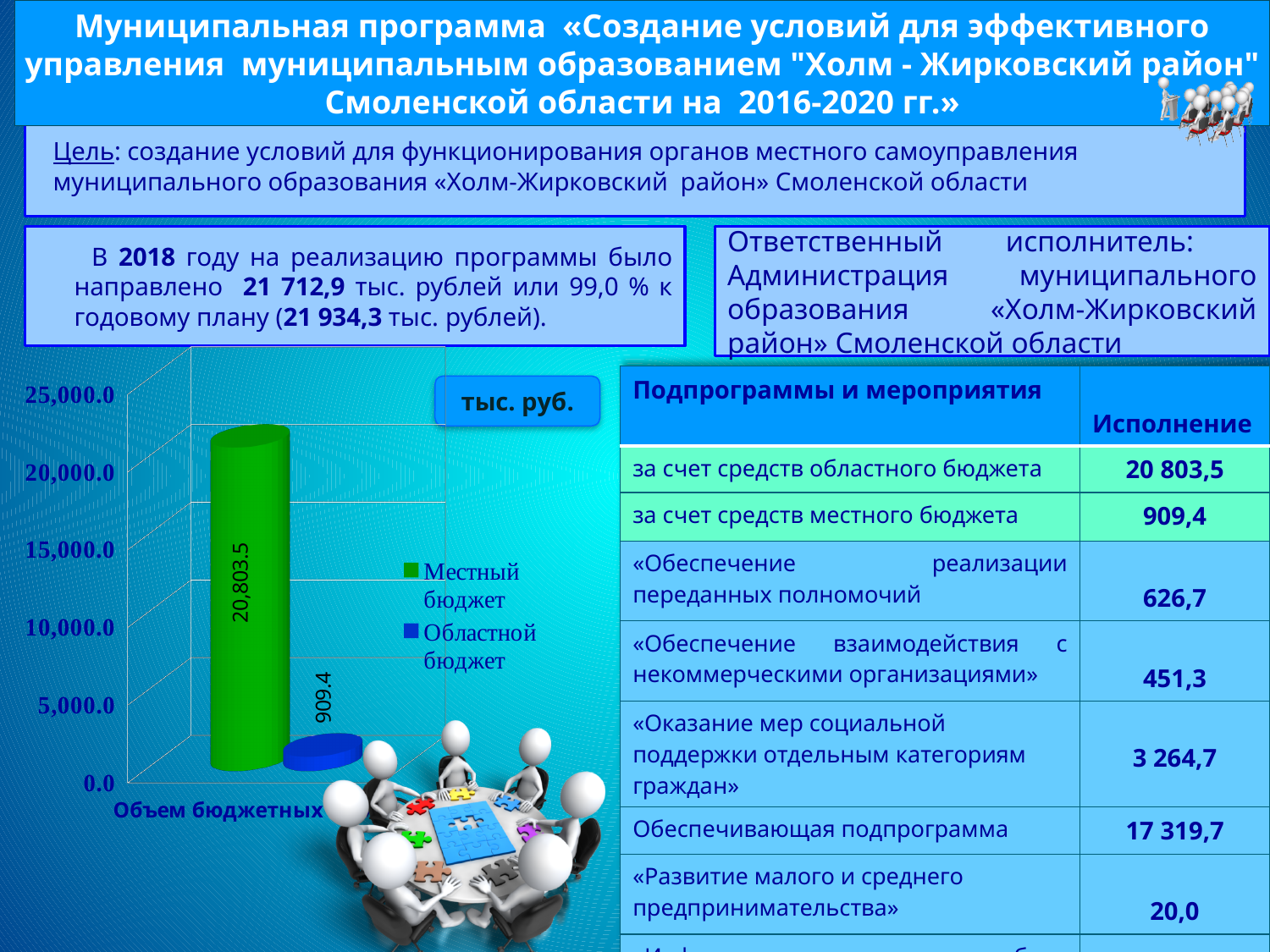
Which colour does the legend assign to «Областной бюджет»? blue What kind of chart is shown on the slide? bar chart Which bar has the larger value, the green one or the blue one? the green bar Is the value of the blue bar greater or less than 5,000.0? less What value is printed on the green bar of the chart? 20,803.5 Is the value of the green bar greater or less than 20,000.0? greater What is the total of the two bar values in the chart? 21,712.9 What unit label is shown in the box above the chart? тыс. руб. How many bars are plotted in the chart? 2 How many series does the chart legend list? 2 What value is printed on the blue bar of the chart? 909.4 What is the difference between the values of the green bar and the blue bar? 19,894.1